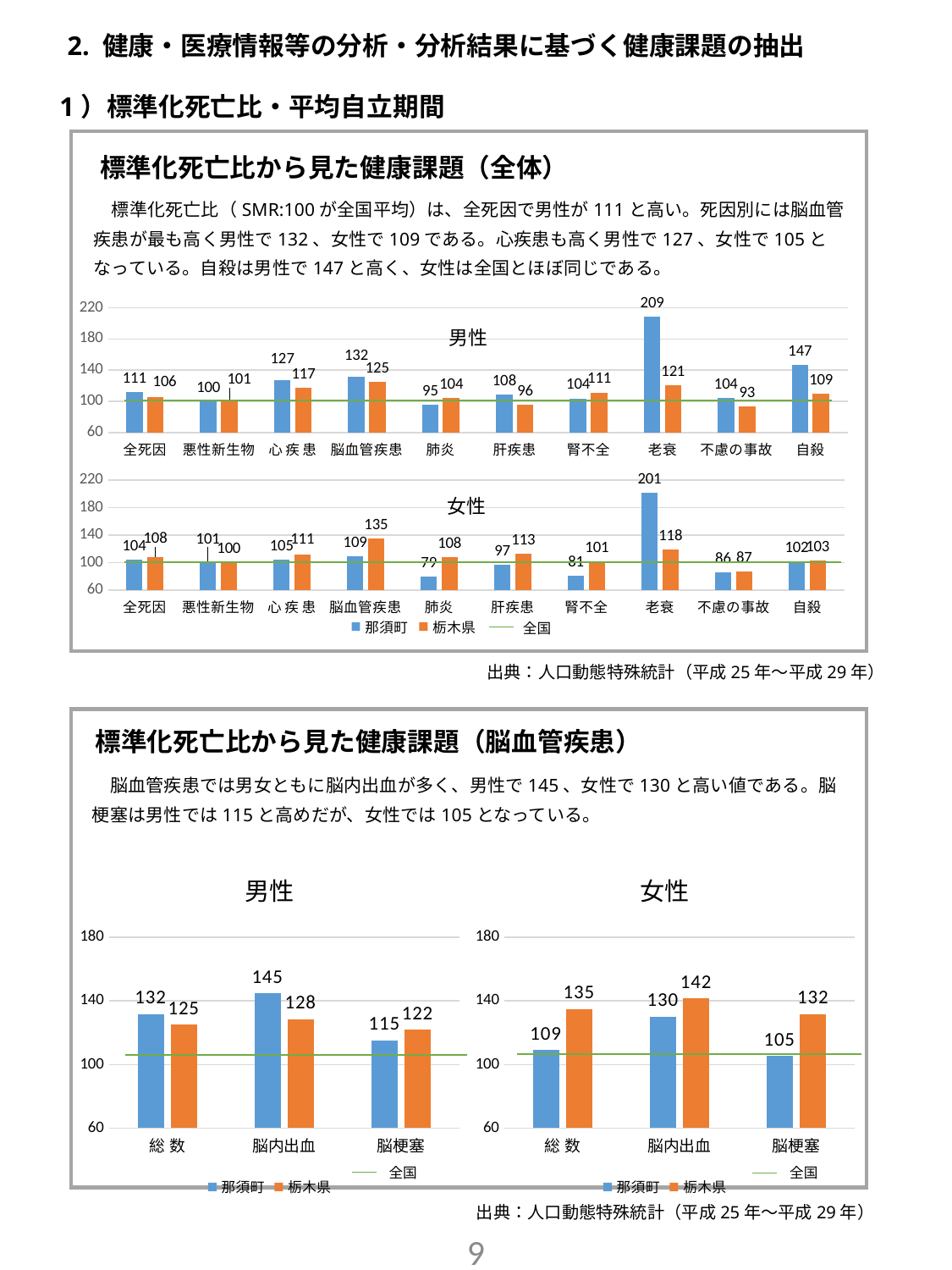
In the top box's 女性 chart, what is the 栃木県 value for 脳血管疾患? 135 In the bottom box's 男性 chart (脳血管疾患), what is the 那須町 value for 脳内出血? 145 How many series does the legend list for the charts in the top box? 3 In the top box's 男性 chart, what is the 栃木県 value for 脳血管疾患? 125 How many categories are shown on the x axis of the top box's 男性 chart? 10 In the bottom box's 女性 chart (脳血管疾患), what is the difference between the 栃木県 and 那須町 values for 脳梗塞? 27 In the top box's 女性 chart, which is larger for 肝疾患: the 那須町 value or the 栃木県 value? 栃木県 In the top box's 男性 chart, what is the difference between the 那須町 and 栃木県 values for 自殺? 38 In the top box's 女性 chart, which category has the highest 那須町 value? 老衰 What kind of chart is the bottom box's 女性 chart? bar chart In the top box's 男性 chart, which category has the highest 那須町 value? 老衰 In the top box's 男性 chart (標準化死亡比から見た健康課題（全体）), what is the 那須町 value for 老衰? 209